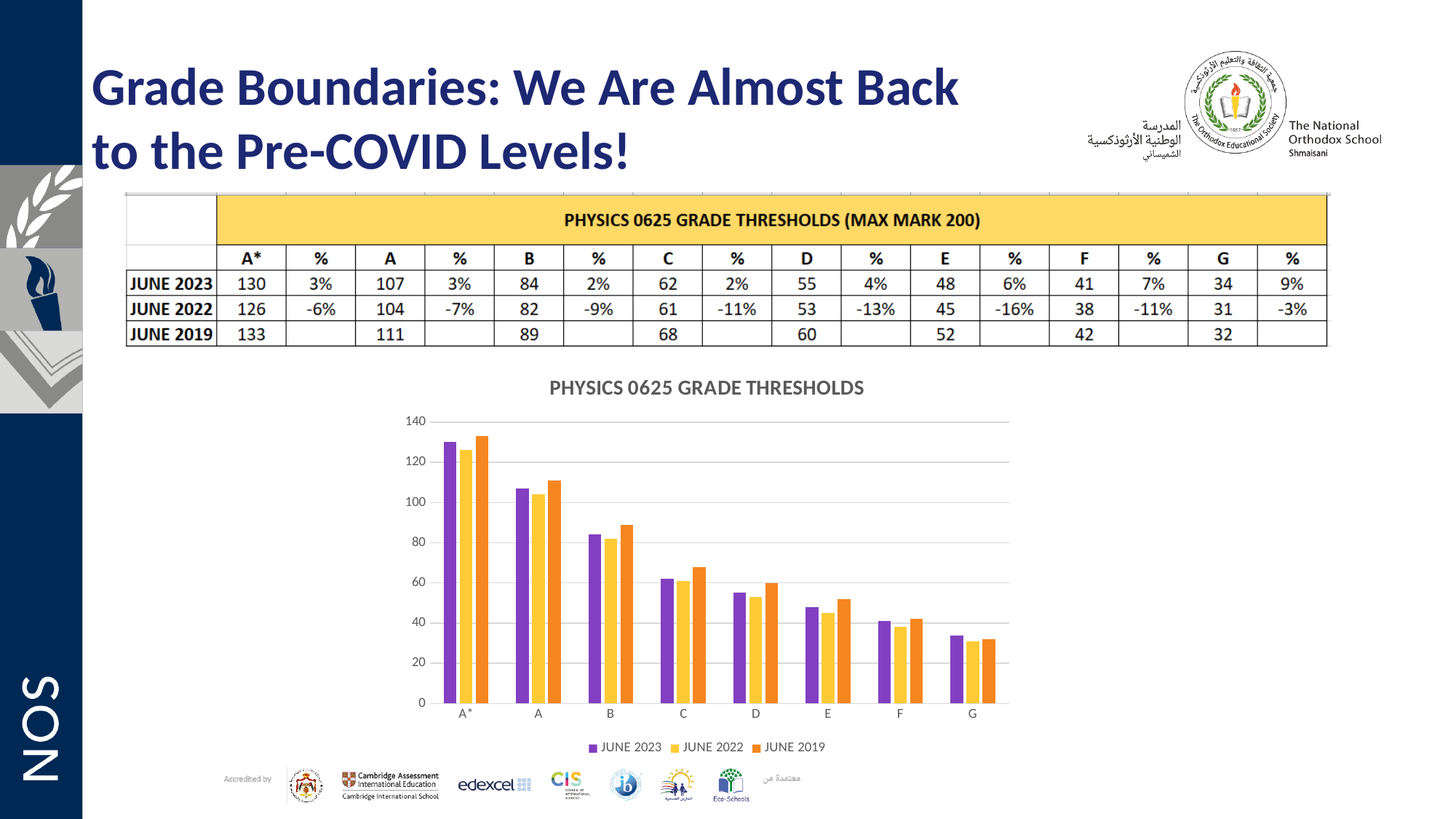
Do the JUNE 2023 thresholds rise or fall moving from A* to G along the x axis? fall How many grade categories are shown on the x axis of the PHYSICS 0625 GRADE THRESHOLDS chart? 8 Which is larger for grade C: the JUNE 2023 threshold or the JUNE 2019 threshold? JUNE 2019 Is the JUNE 2022 value for grade D greater or less than 60? less Which grade has the lowest JUNE 2019 threshold? G What is the difference between the JUNE 2019 and JUNE 2023 thresholds for grade A? 4 How many series does the legend of the PHYSICS 0625 GRADE THRESHOLDS chart list? 3 What is the JUNE 2023 grade threshold for A*? 130 Which grade has the highest JUNE 2023 threshold? A* What is the JUNE 2019 grade threshold for B? 89 What is the JUNE 2022 grade threshold for E? 45 What kind of chart is shown under the title PHYSICS 0625 GRADE THRESHOLDS? bar chart